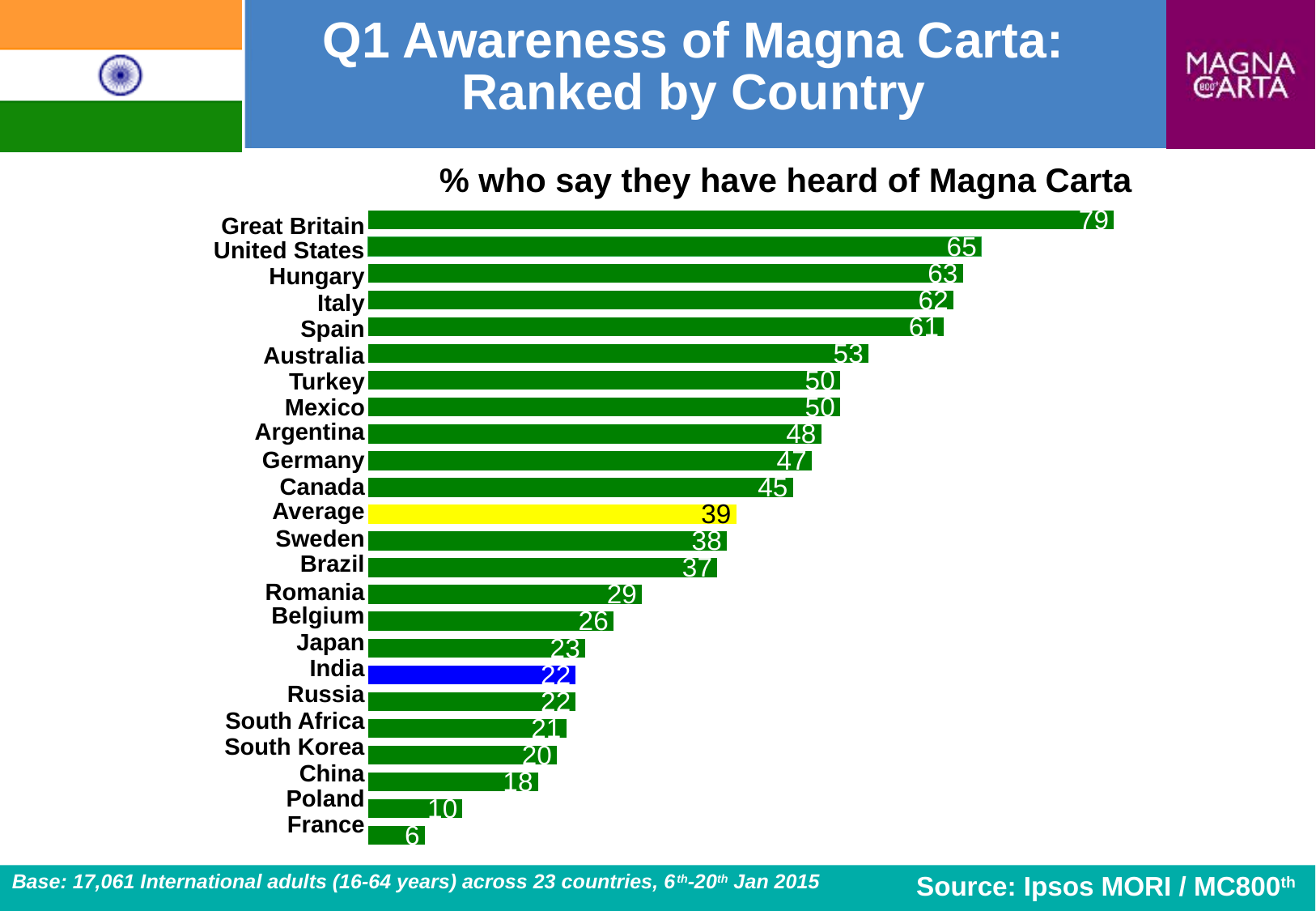
What is the value for India? 22 Which country has the highest value? Great Britain Which country has the lowest value? France What kind of chart is shown? Bar chart Which is larger, the value for Japan or the value for China? Japan Which bar is coloured blue? India What is the difference between the values for India and the Average? 17 What is the value for Poland? 10 What is the difference between the values for Great Britain and the United States? 14 How many bars are plotted in the chart? 24 What is the value for Great Britain? 79 What is the value shown for Average? 39